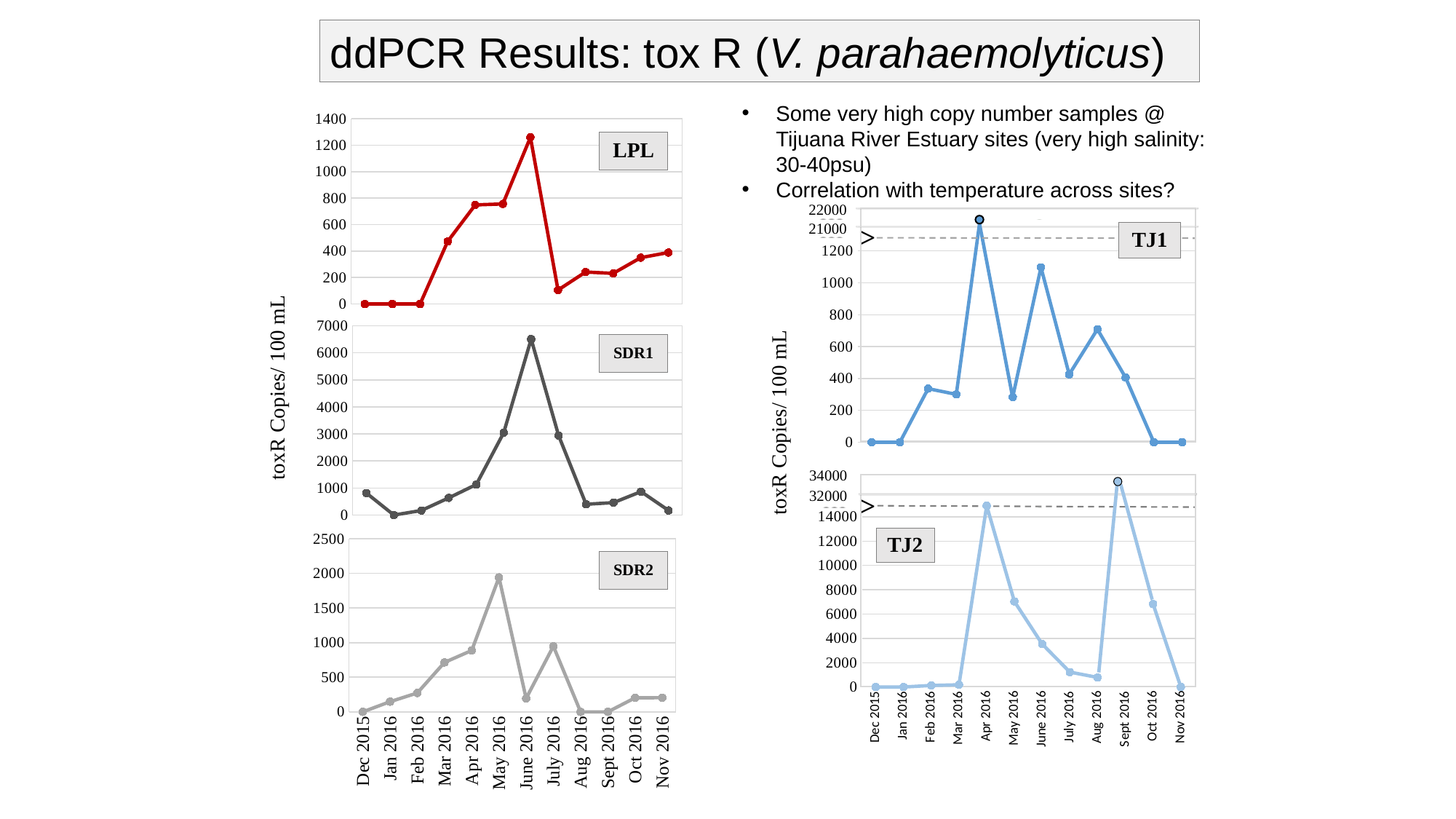
In the SDR1 chart, is the value for June 2016 greater or less than 6000? greater In the LPL chart, what is the value for Jan 2016? 0 In the LPL chart, is the value for July 2016 greater or less than 200? less In the TJ2 chart, is the value for Oct 2016 greater or less than 8000? less In the SDR2 chart, what is the value for Aug 2016? 0 In the TJ2 chart, which month has the highest value? Sept 2016 What kind of chart is the LPL chart? line chart In the SDR1 chart, which month has the highest value? June 2016 In the SDR2 chart, which month has the highest value? May 2016 How many time points are plotted along the x axis of the SDR2 chart? 12